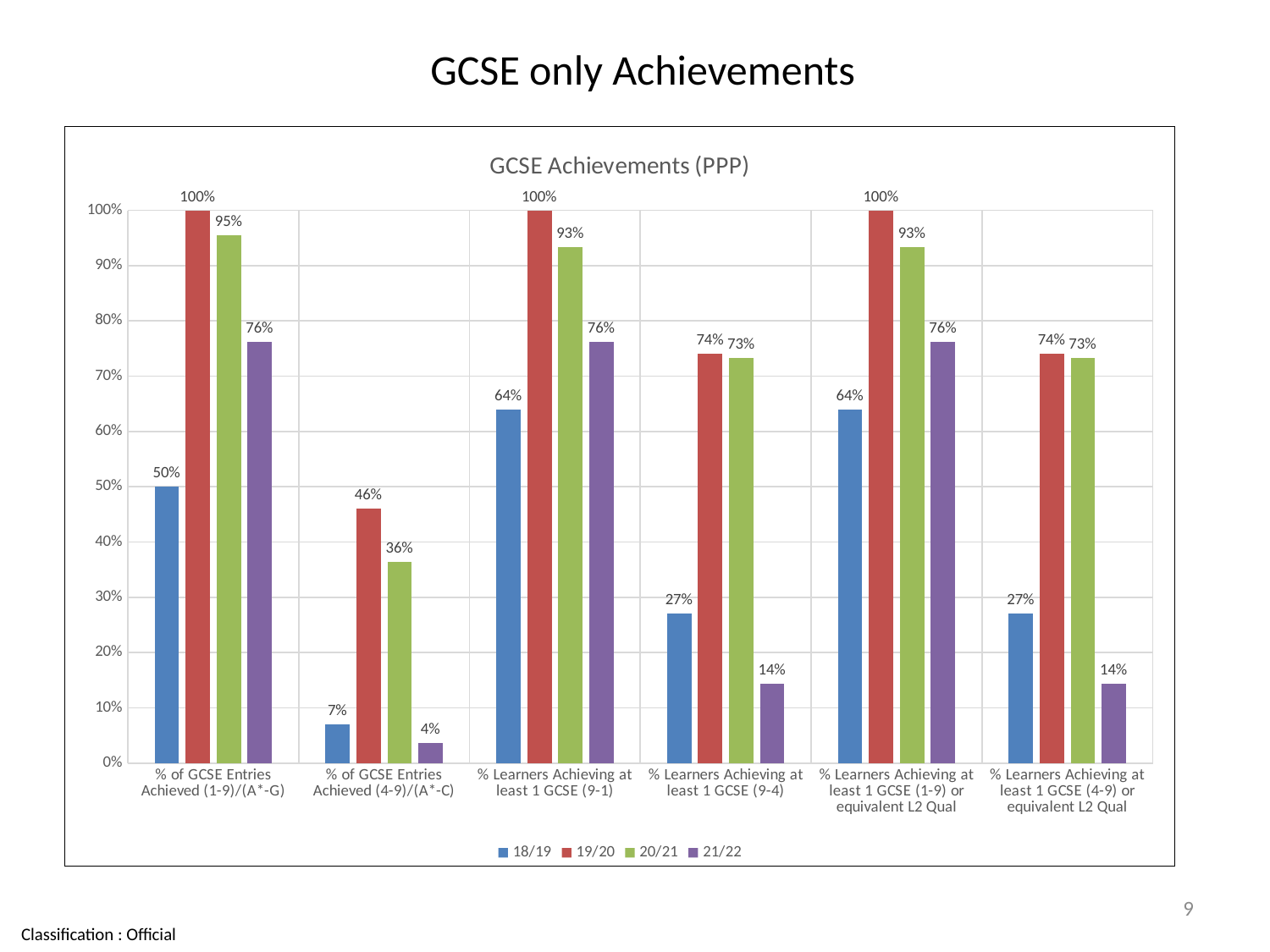
What is the 18/19 value for % of GCSE Entries Achieved (1-9)/(A*-G)? 50% Which is larger for % Learners Achieving at least 1 GCSE (4-9) or equivalent L2 Qual: the 18/19 value or the 21/22 value? 18/19 Which series has the highest value for % of GCSE Entries Achieved (4-9)/(A*-C)? 19/20 What type of chart is shown on the slide? Bar chart How many series does the legend list? 4 Which series has the lowest value for % Learners Achieving at least 1 GCSE (9-4)? 21/22 What is the 19/20 value for % Learners Achieving at least 1 GCSE (9-4)? 74% What is the 20/21 value for % Learners Achieving at least 1 GCSE (9-1)? 93% How many categories are shown on the x axis? 6 What is the title of the chart? GCSE Achievements (PPP) What is the 21/22 value for % of GCSE Entries Achieved (4-9)/(A*-C)? 4% What is the difference between the 19/20 and 18/19 values for % of GCSE Entries Achieved (1-9)/(A*-G)? 50%